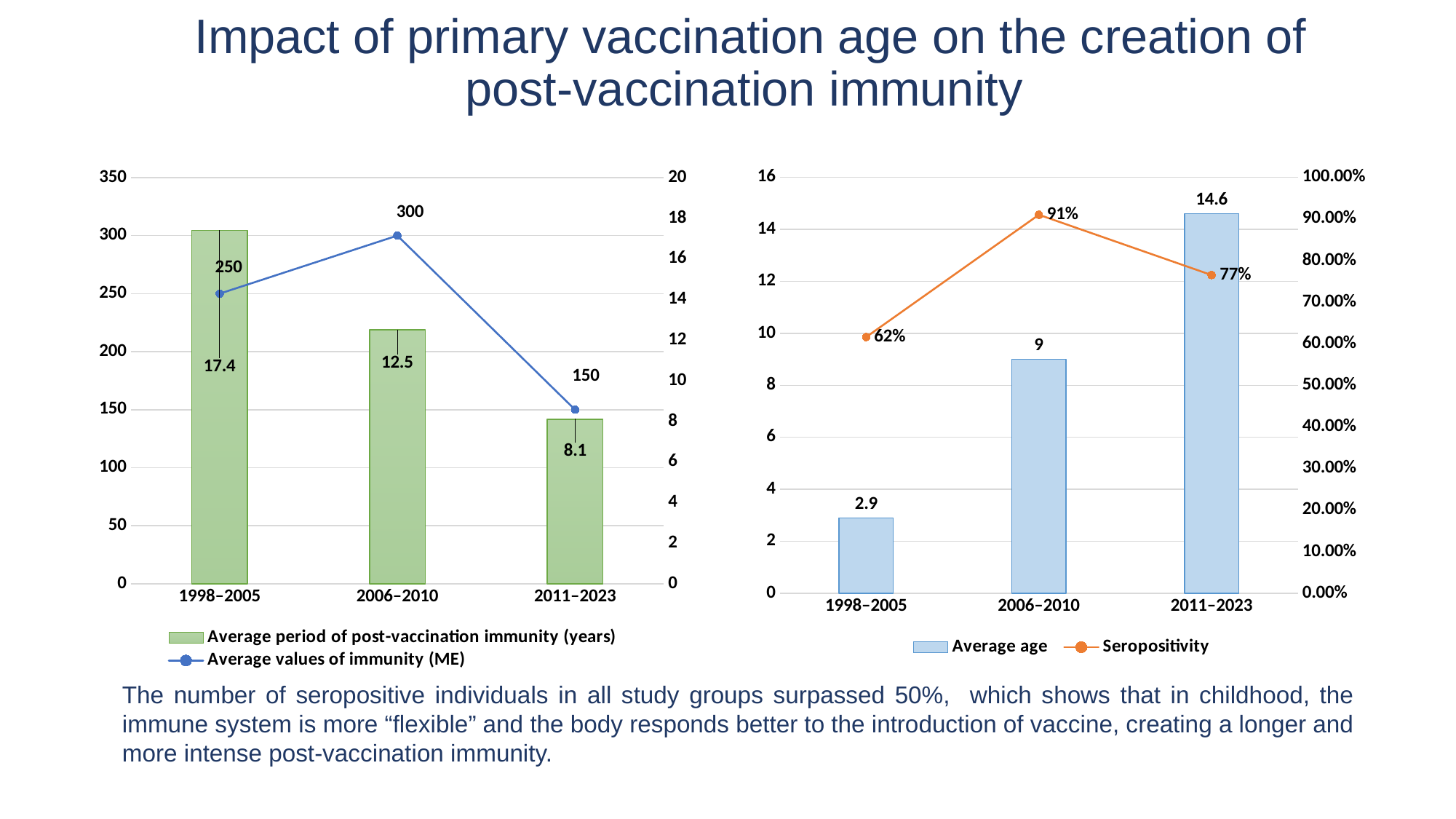
In the left chart, what is the average value of immunity (ME) for 2006–2010? 300 In the right chart, is the average age for 2006–2010 larger or smaller than for 1998–2005? larger In the left chart, which period has the lowest average value of immunity (ME)? 2011–2023 In the right chart, which period has the highest seropositivity? 2006–2010 In the right chart, what is the seropositivity for 1998–2005? 62% In the left chart, what is the average period of post-vaccination immunity for 1998–2005? 17.4 In the left chart, what is the difference between the average period of post-vaccination immunity for 1998–2005 and 2011–2023? 9.3 In the right chart, what is the difference in seropositivity between 2006–2010 and 2011–2023? 14% In the right chart, what is the average age for 2011–2023? 14.6 In the left chart, does the average period of post-vaccination immunity rise or fall from 1998–2005 to 2011–2023? fall How many series does the legend of the left chart list? 2 How many periods are shown on the x axis of the right chart? 3